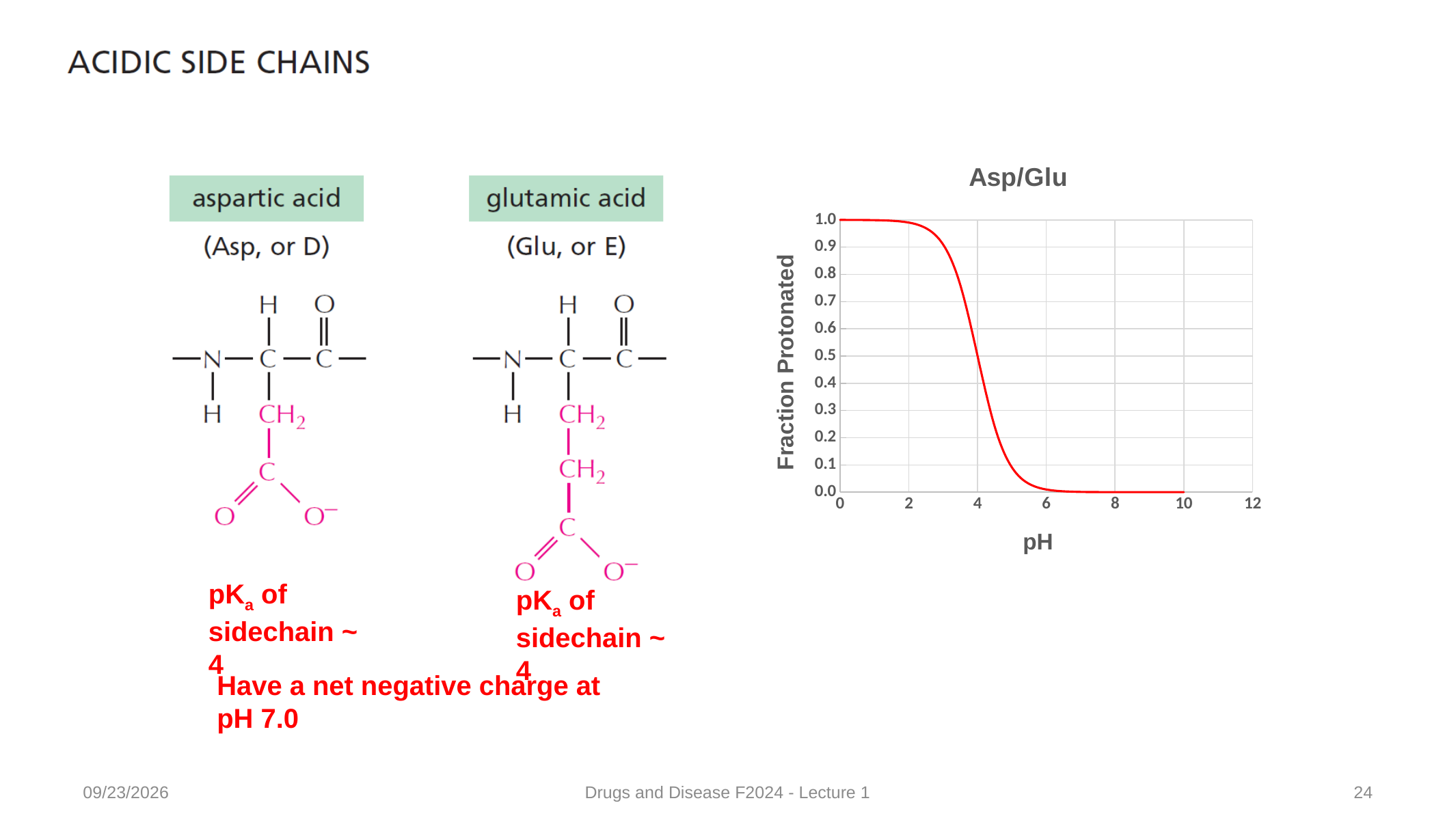
What is the highest pH value labelled on the x axis? 12 What is the label of the y axis of the chart? Fraction Protonated Is the fraction protonated at pH 8 greater or less than 0.1? less Does the fraction protonated rise or fall as pH increases along the x axis? fall What is the title of the chart? Asp/Glu Is the fraction protonated at pH 2 greater or less than 0.9? greater Which has a higher fraction protonated, pH 2 or pH 6? pH 2 Is the fraction protonated at pH 4 greater or less than 0.8? less What kind of chart is shown on the slide? line chart